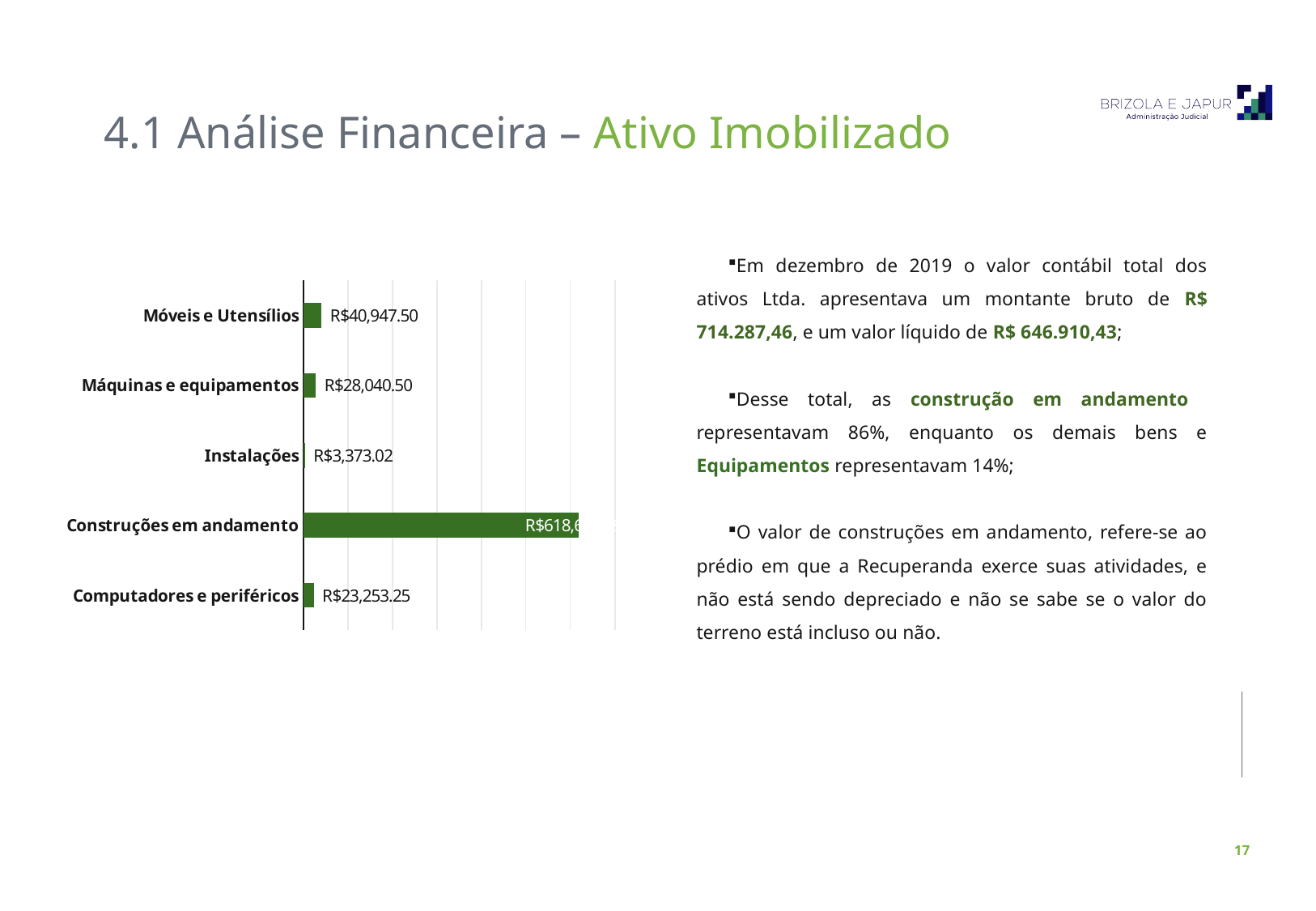
What is the value for Móveis e Utensílios? R$40,947.50 What is the value for Máquinas e equipamentos? R$28,040.50 Which is larger, the value for Móveis e Utensílios or the value for Computadores e periféricos? Móveis e Utensílios Which category has the lowest value? Instalações What is the value for Instalações? R$3,373.02 What is the difference between the values for Máquinas e equipamentos and Computadores e periféricos? R$4,787.25 Which category has the highest value? Construções em andamento What is the value for Computadores e periféricos? R$23,253.25 What colour are the bars in the chart? Green What kind of chart is shown on the slide? Bar chart What is the difference between the values for Móveis e Utensílios and Máquinas e equipamentos? R$12,907.00 How many categories are shown in the chart? 5